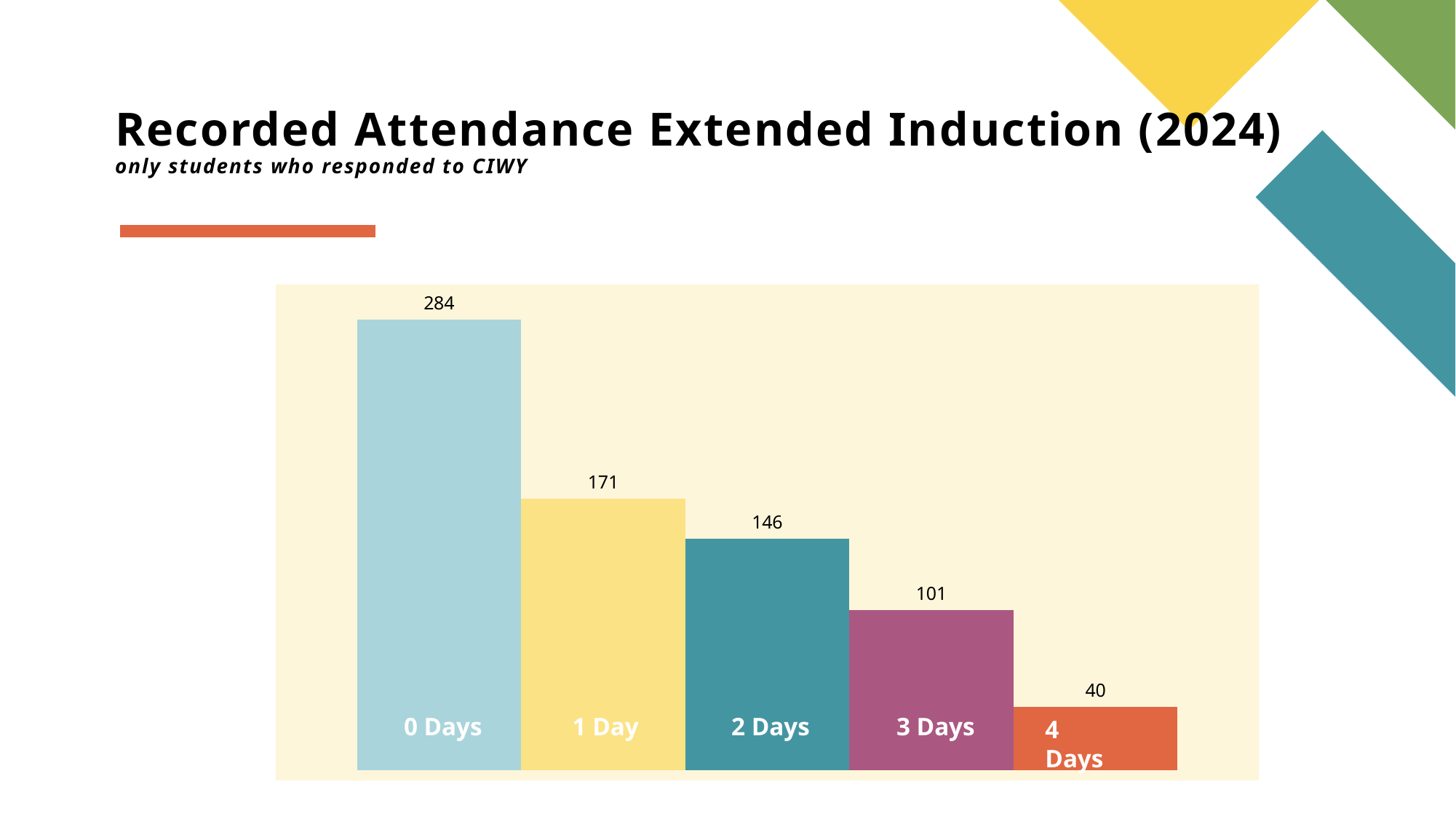
What kind of chart is shown on the slide? Bar chart What is the value for 0 Days? 284 What is the value for 3 Days? 101 Which is larger, the value for 2 Days or the value for 3 Days? 2 Days What is the difference between the values for 0 Days and 1 Day? 113 What is the value for 2 Days? 146 Which category has the highest value? 0 Days Do the values rise or fall from 0 Days to 4 Days? Fall What is the value for 1 Day? 171 How many categories are shown in the chart? 5 What is the value for 4 Days? 40 Which category has the lowest value? 4 Days